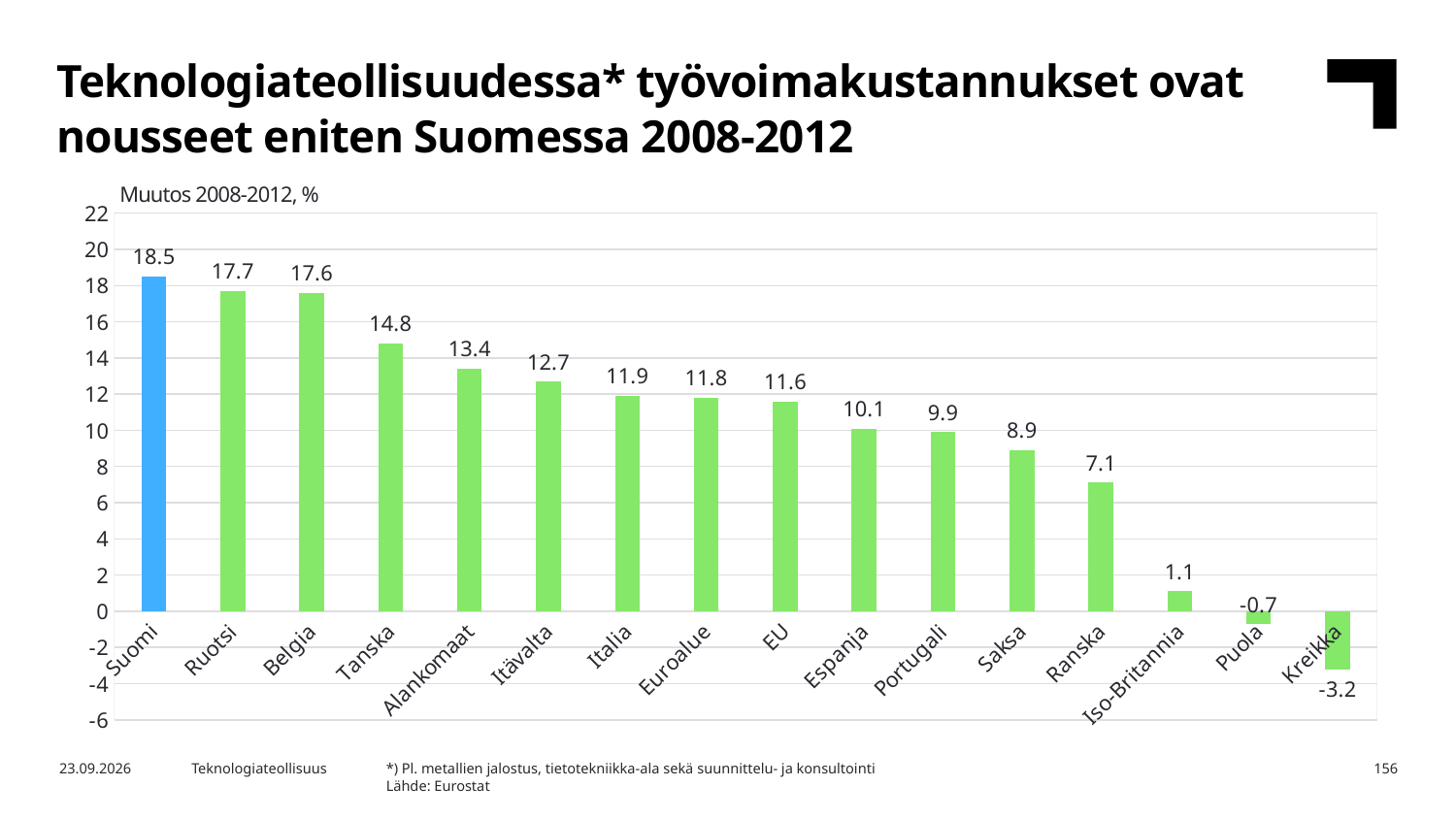
What is the label shown above the chart's y axis? Muutos 2008-2012, % What is the value for Iso-Britannia? 1.1 Which is larger, the value for Espanja or the value for Ranska? Espanja Which country has the lowest value? Kreikka How many categories are shown on the x axis? 16 Which country has the highest value? Suomi What is the difference between the values for Suomi and Ruotsi? 0.8 What is the difference between the values for Tanska and Saksa? 5.9 What kind of chart is shown on the slide? Bar chart What is the value for Kreikka? -3.2 What is the value for Suomi? 18.5 What is the value for Alankomaat? 13.4